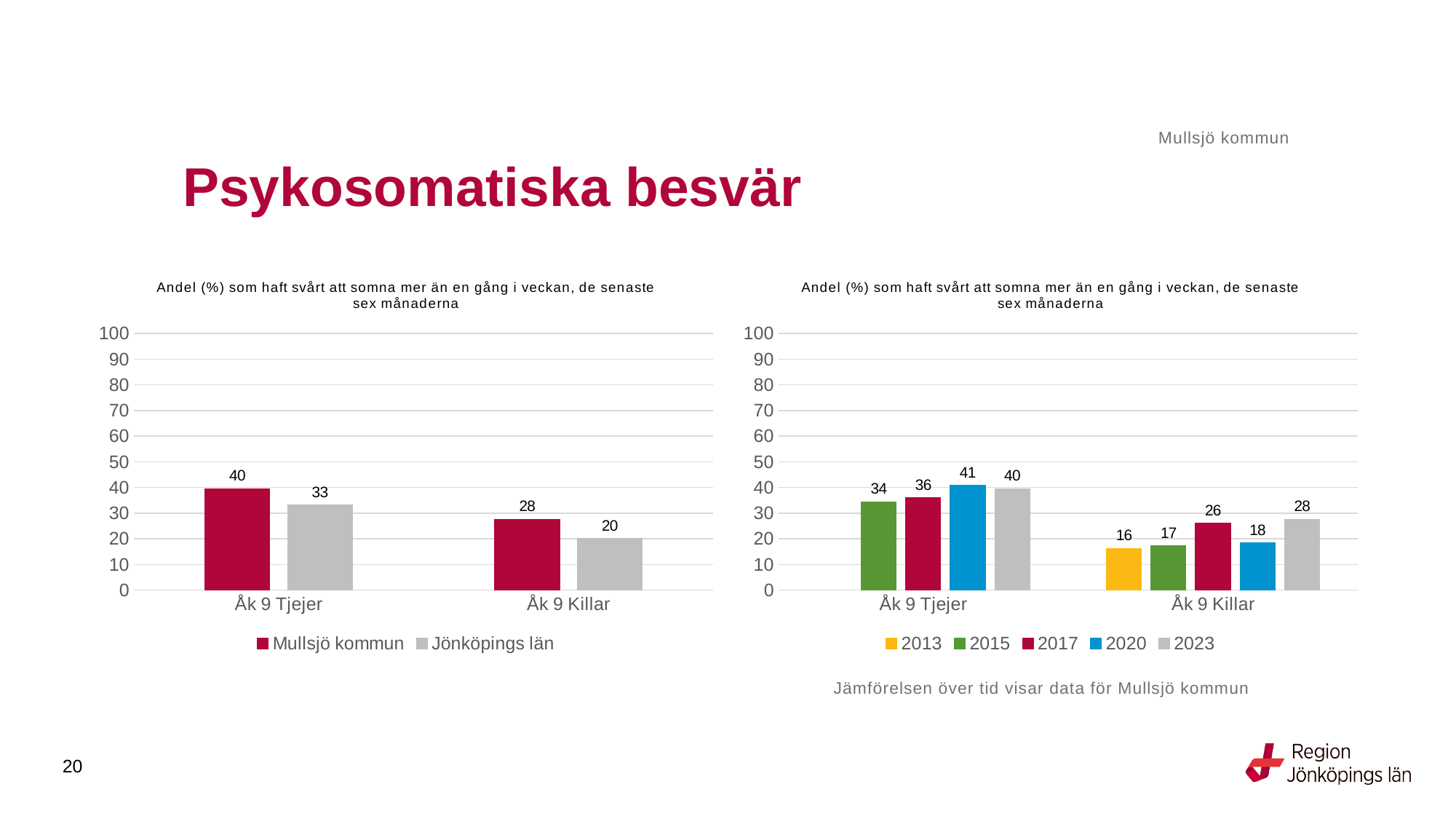
In the right chart, what is the value for 2020 for Åk 9 Tjejer? 41 In the left chart, what is the value for Mullsjö kommun for Åk 9 Tjejer? 40 In the left chart, which is larger for Åk 9 Tjejer: Mullsjö kommun or Jönköpings län? Mullsjö kommun In the left chart, what is the value for Jönköpings län for Åk 9 Killar? 20 In the right chart, what is the value for 2013 for Åk 9 Killar? 16 In the right chart, which year has the lowest value for Åk 9 Tjejer? 2015 In the right chart, what is the difference between the 2023 and 2015 values for Åk 9 Killar? 11 In the left chart, how many series does the legend list? 2 In the right chart, which year has the highest value for Åk 9 Killar? 2023 What kind of chart is the left chart? Bar chart In the right chart, how many series does the legend list? 5 In the left chart, what is the difference between Mullsjö kommun and Jönköpings län for Åk 9 Killar? 8